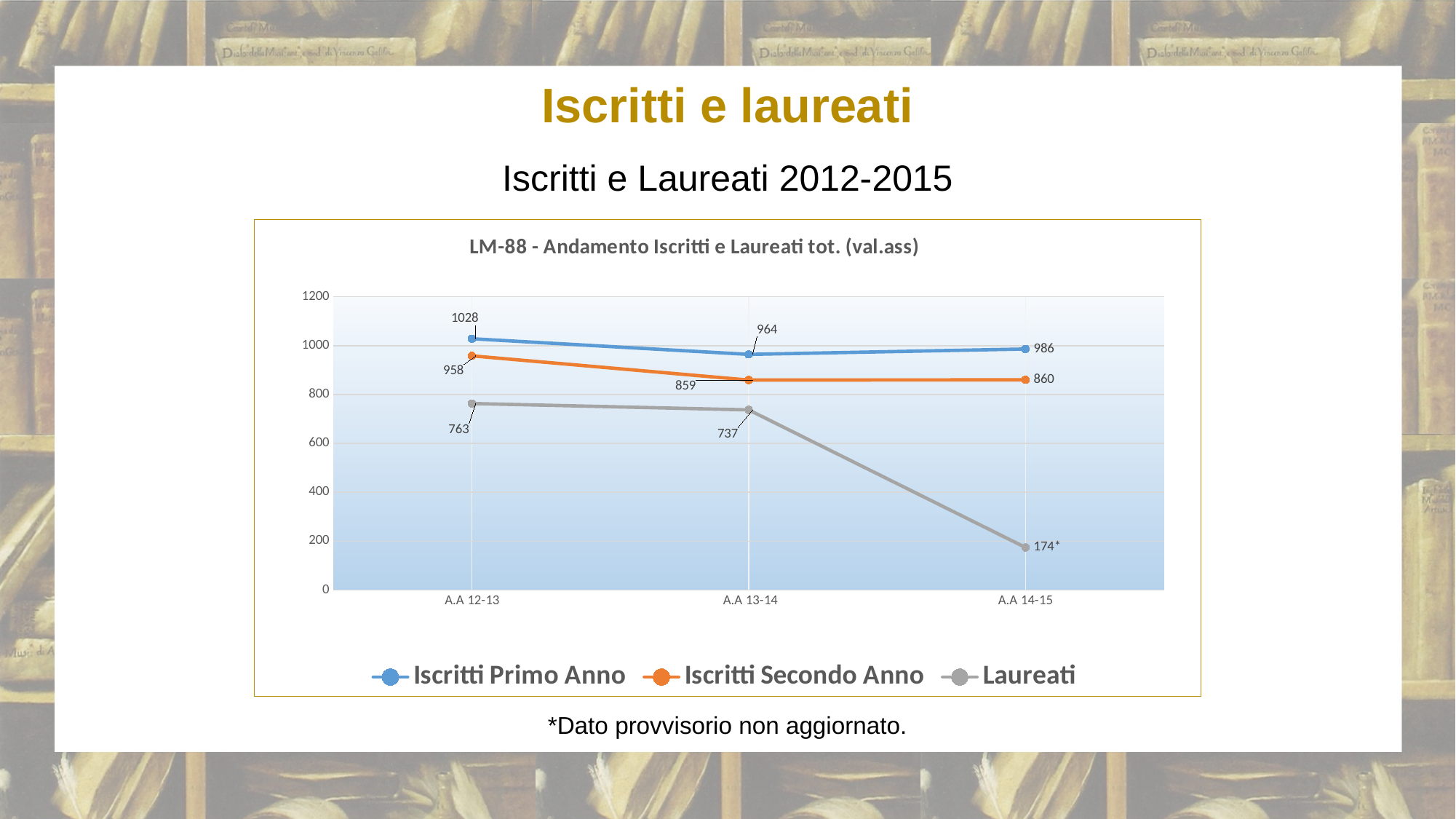
In which academic year is Laureati lowest? A.A 14-15 What kind of chart is shown? line chart Is the value for Laureati in A.A 12-13 greater or less than 600? greater How many series does the legend list? 3 In which academic year is Iscritti Primo Anno highest? A.A 12-13 What is the value for Iscritti Primo Anno in A.A 12-13? 1028 What is the value for Laureati in A.A 14-15? 174* Which is larger in A.A 13-14: Iscritti Primo Anno or Laureati? Iscritti Primo Anno What is the difference between Iscritti Primo Anno and Iscritti Secondo Anno in A.A 14-15? 126 Does the Laureati series rise or fall from A.A 13-14 to A.A 14-15? fall How many academic years are shown on the x axis? 3 What is the value for Iscritti Secondo Anno in A.A 13-14? 859